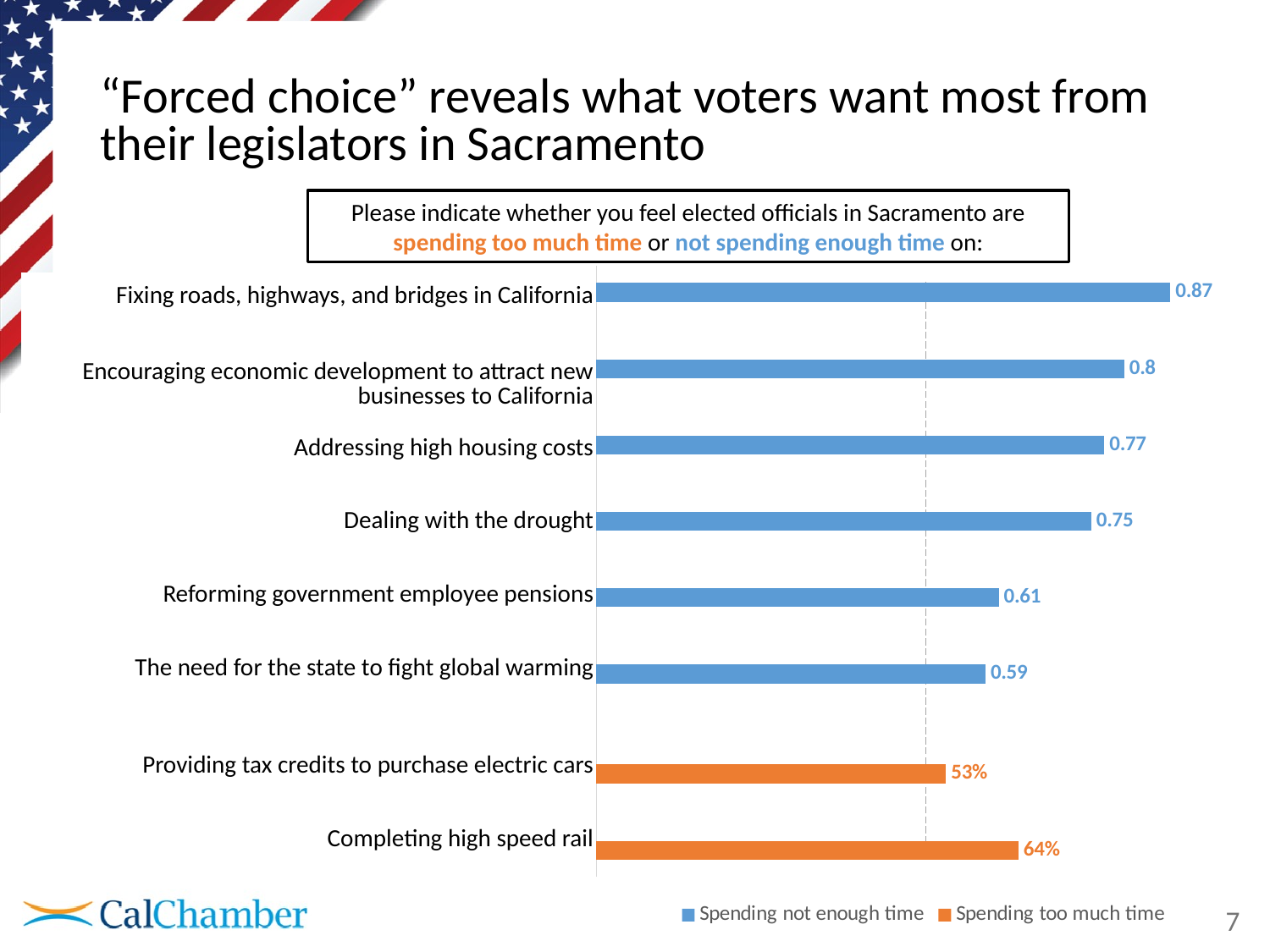
What is the value shown for "Fixing roads, highways, and bridges in California"? 0.87 What is the difference between the values for "Completing high speed rail" and "Providing tax credits to purchase electric cars"? 11 percentage points Which category has the lowest value among the "Spending not enough time" bars? The need for the state to fight global warming How many series does the legend list? 2 How many categories are shown in the chart? 8 Which category has the highest value among the "Spending not enough time" bars? Fixing roads, highways, and bridges in California What kind of chart is shown on the slide? Bar chart Which has a larger value: "Dealing with the drought" or "Reforming government employee pensions"? Dealing with the drought What is the value shown for "Providing tax credits to purchase electric cars"? 53% What is the difference between the values for "Fixing roads, highways, and bridges in California" and "Encouraging economic development to attract new businesses to California"? 0.07 What is the value shown for "Completing high speed rail"? 64% What is the value shown for "Addressing high housing costs"? 0.77